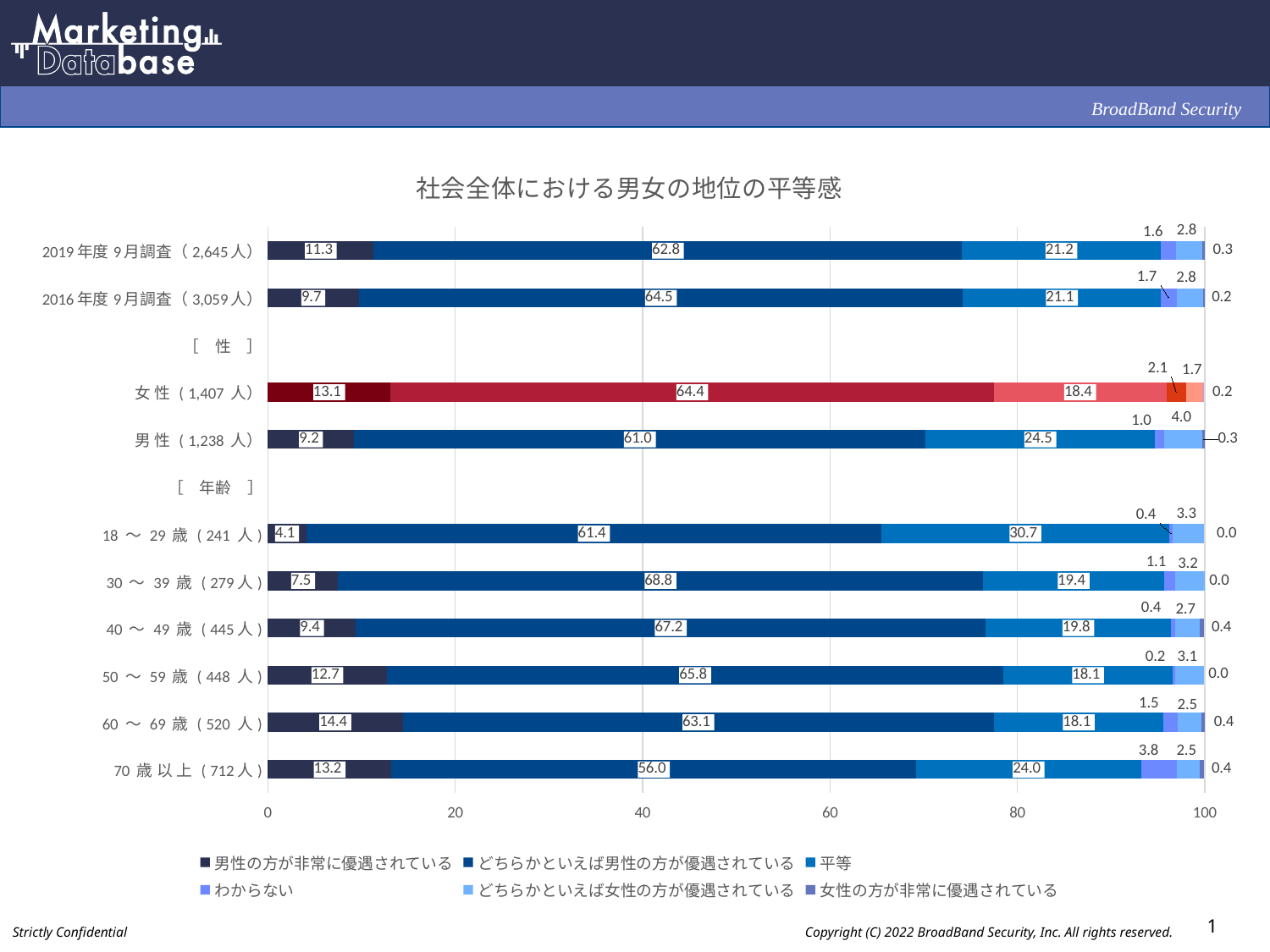
What is the value of 平等 for 2019年度 9月調査 (2,645人)? 21.2 How many series does the legend list? 6 Which category has the highest value for 平等? 18～29歳 (241人) What type of chart is shown on the slide? Stacked bar chart What is the value of どちらかといえば男性の方が優遇されている for 女性 (1,407人)? 64.4 What is the value of どちらかといえば男性の方が優遇されている for 70歳以上 (712人)? 56.0 Which has a larger value for 男性の方が非常に優遇されている, 女性 (1,407人) or 男性 (1,238人)? 女性 (1,407人) Which category has the lowest value for 男性の方が非常に優遇されている? 18～29歳 (241人) What is the title of the chart? 社会全体における男女の地位の平等感 Which category has the highest value for どちらかといえば男性の方が優遇されている? 30～39歳 (279人) What is the value of 男性の方が非常に優遇されている for 60～69歳 (520人)? 14.4 What is the difference in 男性の方が非常に優遇されている between 2019年度 9月調査 and 2016年度 9月調査? 1.6